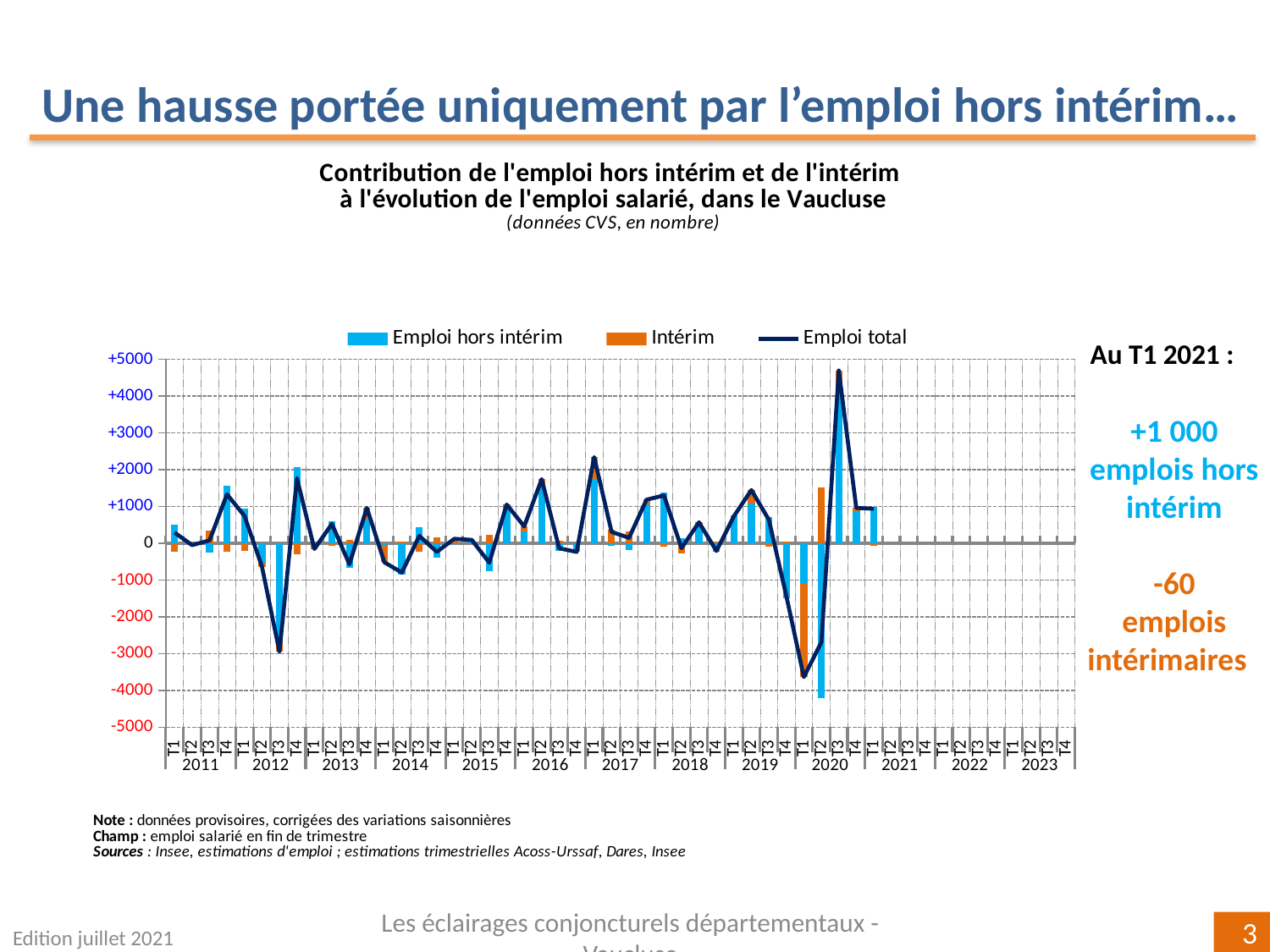
How many series does the chart legend list? 3 Is the value of Emploi total at T1 2020 greater or less than -3000? less According to the slide, what is the value for Intérim at T1 2021? -60 Is the value of Emploi hors intérim at T2 2020 greater or less than -4000? less What is the title of the chart? Contribution de l'emploi hors intérim et de l'intérim à l'évolution de l'emploi salarié, dans le Vaucluse In which quarter does the Emploi total line reach its lowest value? T1 2020 According to the slide, what is the value for Emploi hors intérim at T1 2021? +1 000 Which is larger, the Emploi total value at T3 2020 or at T1 2017? T3 2020 What kind of chart is shown on the slide? Combined bar and line chart Is the value of Emploi total at T3 2020 greater or less than +4000? greater Which series is drawn as a dark blue line in the chart? Emploi total In which quarter does the Emploi total line reach its highest value? T3 2020